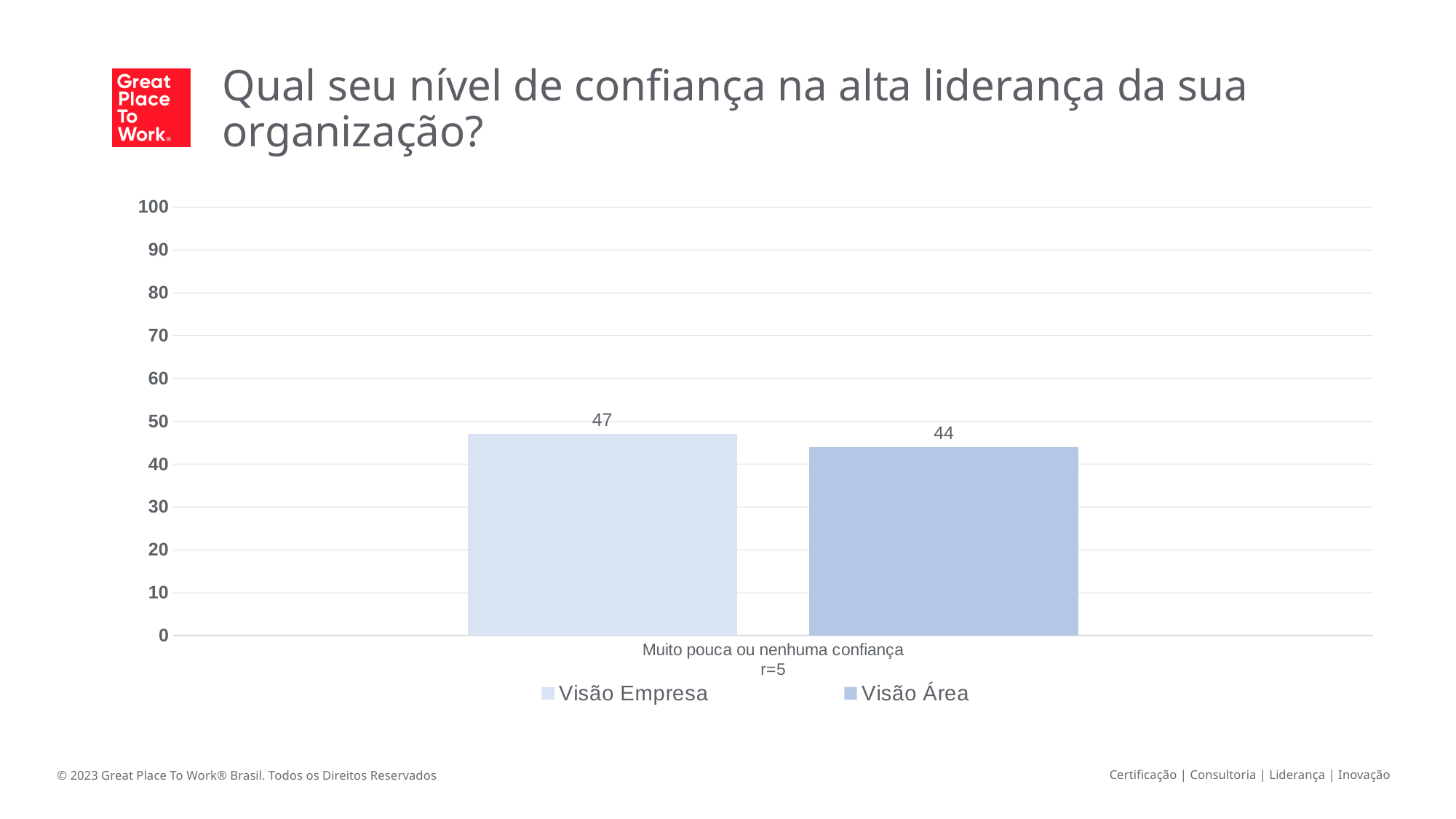
Is the value for Visão Área greater or less than 50? less What is the label of the category on the x axis? Muito pouca ou nenhuma confiança r=5 What is the maximum value shown on the y axis? 100 What is the value for Visão Área in the 'Muito pouca ou nenhuma confiança' category? 44 What kind of chart is shown on the slide? Bar chart What is the value for Visão Empresa in the 'Muito pouca ou nenhuma confiança' category? 47 What is the difference between the Visão Empresa value and the Visão Área value? 3 How many categories are shown on the x axis? 1 Is the value for Visão Empresa greater or less than 40? greater How many series does the legend list? 2 Which series has the higher value, Visão Empresa or Visão Área? Visão Empresa